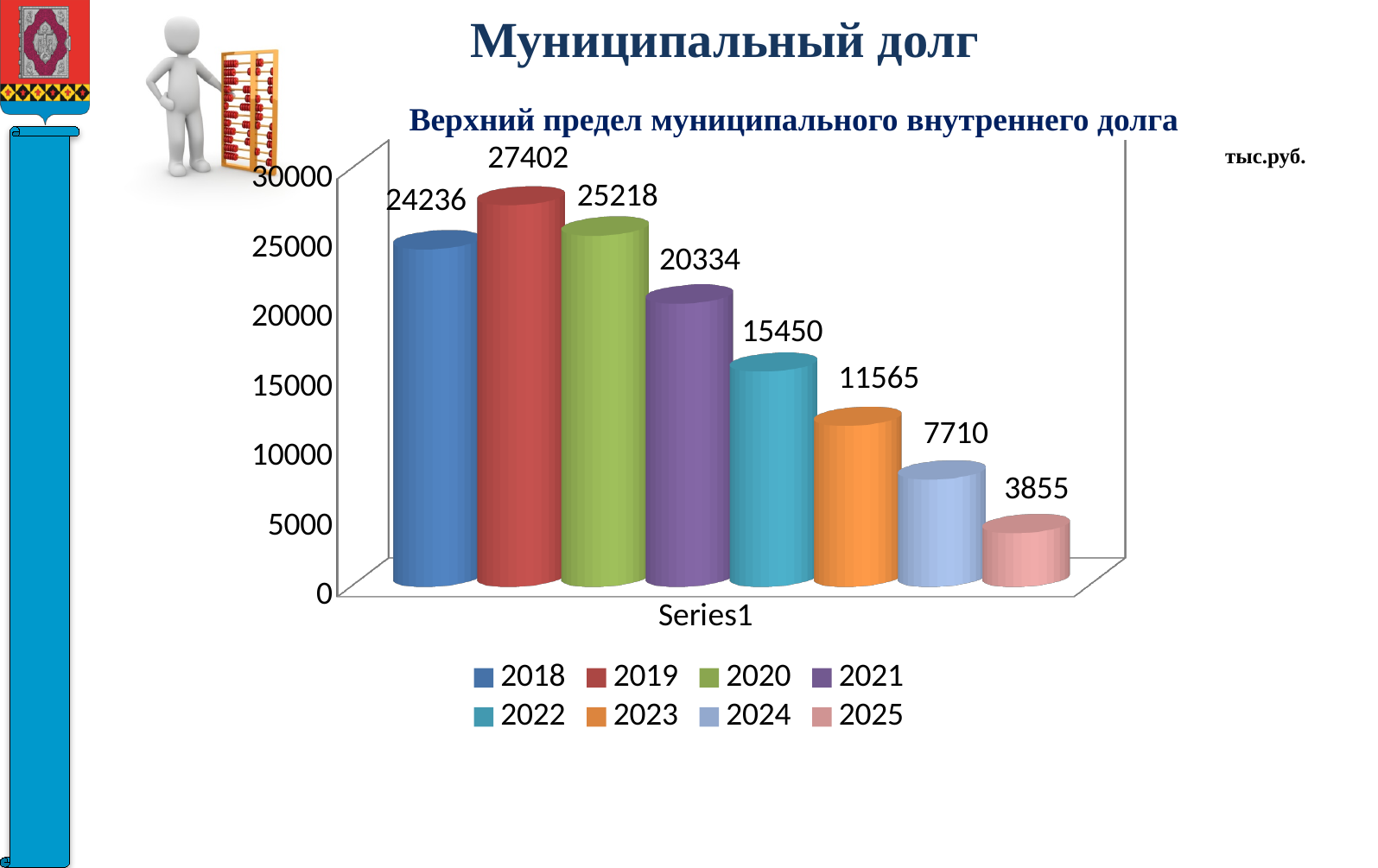
What is the value for 2019? 27402 Which is larger, the value for 2018 or the value for 2020? 2020 What kind of chart is shown? bar chart What is the difference between the values for 2019 and 2020? 2184 How many series does the legend list? 8 Is the value for 2021 greater or less than 20000? greater Which year has the lowest value? 2025 What is the value for 2022? 15450 Which year has the highest value? 2019 What unit is indicated next to the chart? тыс.руб. What is the value for 2025? 3855 What is the difference between the values for 2024 and 2025? 3855